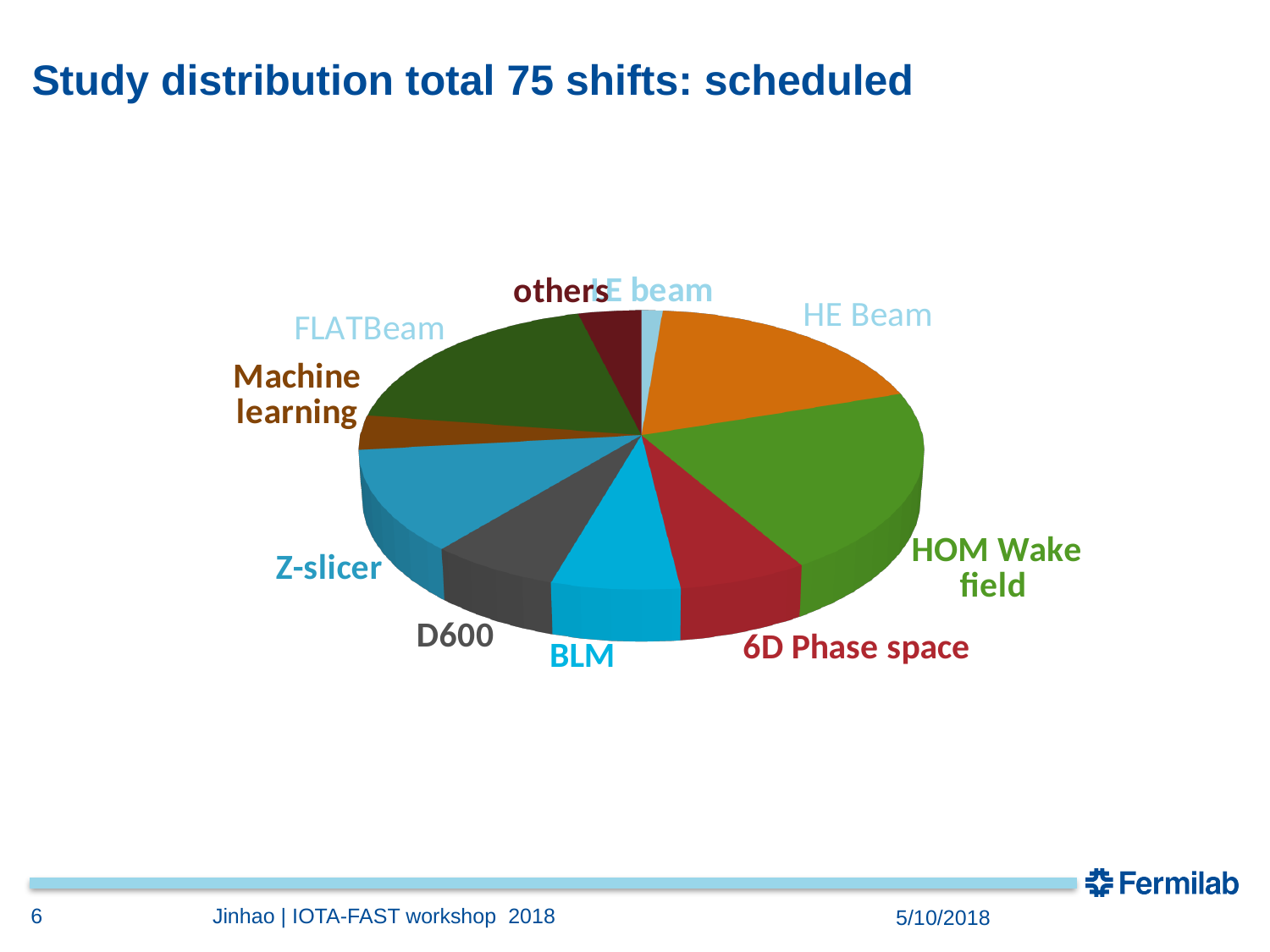
How many slices does the pie chart have? 10 Which slice is larger, Z-slicer or others? Z-slicer What colour is the HOM Wake field slice of the pie chart? Green Which study category has the smallest slice of the pie? LE beam Which study category has the largest slice of the pie? HOM Wake field Which slice is larger, HOM Wake field or BLM? HOM Wake field Which slice is larger, LE beam or D600? D600 What is the title of the slide containing the pie chart? Study distribution total 75 shifts: scheduled What kind of chart is shown on the slide? Pie chart